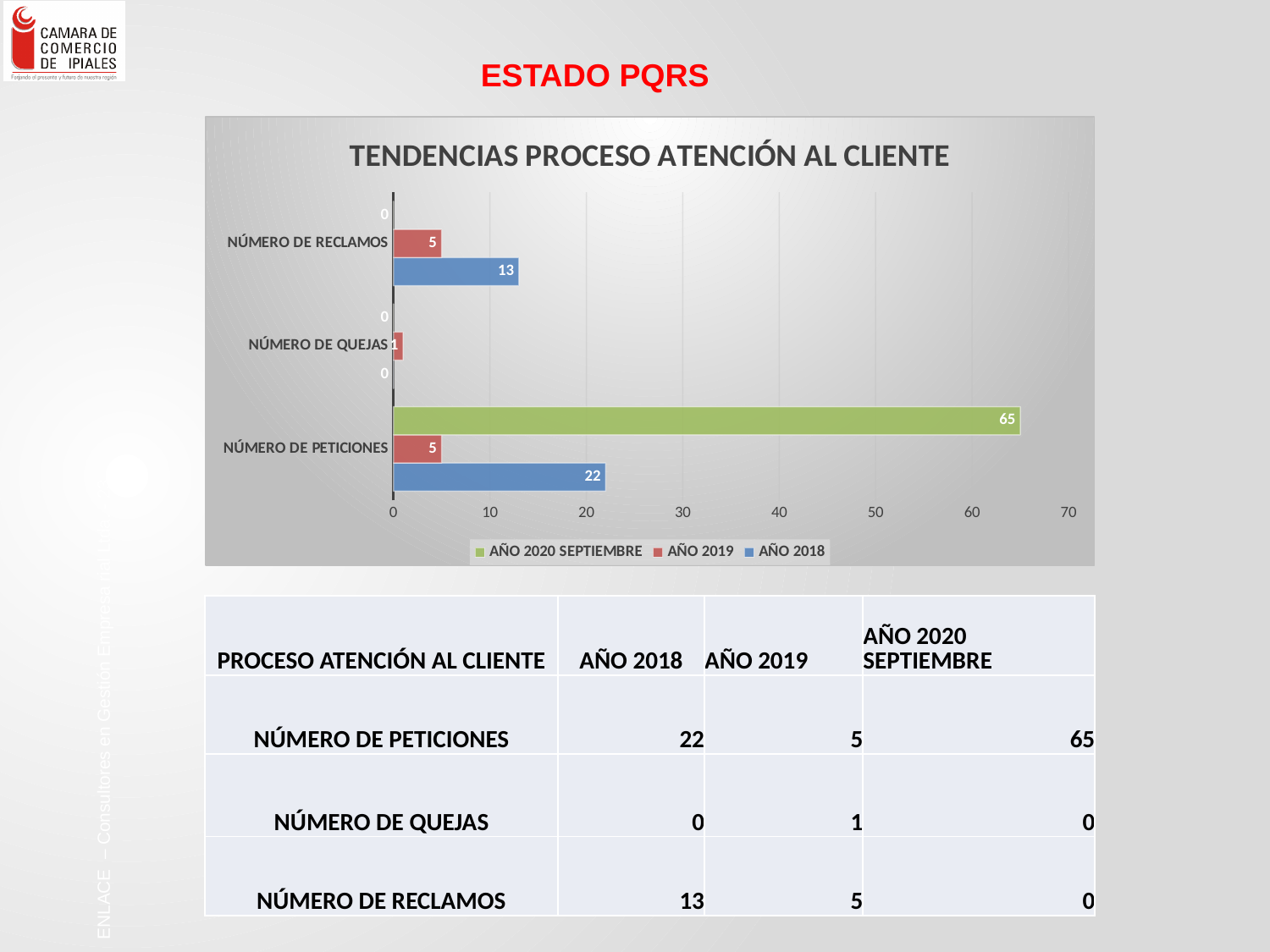
What kind of chart is shown on the slide? Bar chart What is the value for NÚMERO DE PETICIONES in the AÑO 2019 series? 5 What is the value for NÚMERO DE PETICIONES in the AÑO 2020 SEPTIEMBRE series? 65 What is the difference between the AÑO 2020 SEPTIEMBRE and AÑO 2018 values for NÚMERO DE PETICIONES? 43 Which category has the highest value in the AÑO 2018 series? NÚMERO DE PETICIONES How many series does the legend list? 3 What is the value for NÚMERO DE RECLAMOS in the AÑO 2018 series? 13 How many categories are shown on the chart? 3 Which category has the lowest value in the AÑO 2018 series? NÚMERO DE QUEJAS What is the title of the chart? TENDENCIAS PROCESO ATENCIÓN AL CLIENTE Which is larger for NÚMERO DE RECLAMOS: the AÑO 2018 value or the AÑO 2019 value? AÑO 2018 What is the value for NÚMERO DE QUEJAS in the AÑO 2019 series? 1